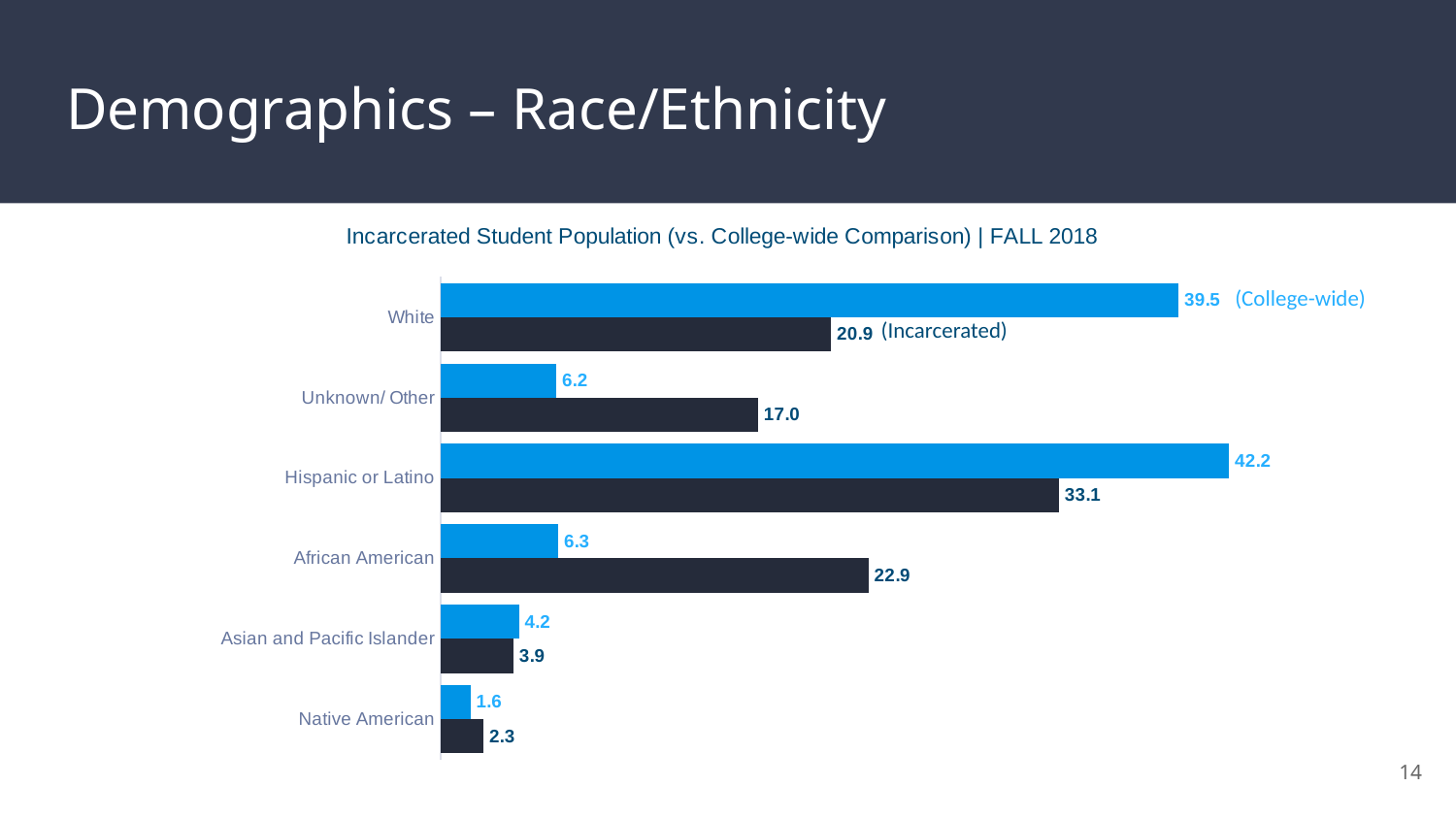
Which is larger for African American, the College-wide value or the Incarcerated value? Incarcerated What kind of chart is shown on the slide? Bar chart How many race/ethnicity categories are shown in the chart? 6 What is the Incarcerated value for Unknown/ Other? 17.0 What is the Incarcerated value for African American? 22.9 Which is larger for Asian and Pacific Islander, the College-wide value or the Incarcerated value? College-wide Which category has the lowest Incarcerated value? Native American Which category has the highest College-wide value? Hispanic or Latino What is the College-wide value for Hispanic or Latino? 42.2 What is the difference between the College-wide and Incarcerated values for White? 18.6 What is the title of the chart? Incarcerated Student Population (vs. College-wide Comparison) | FALL 2018 How many series does the chart show? 2